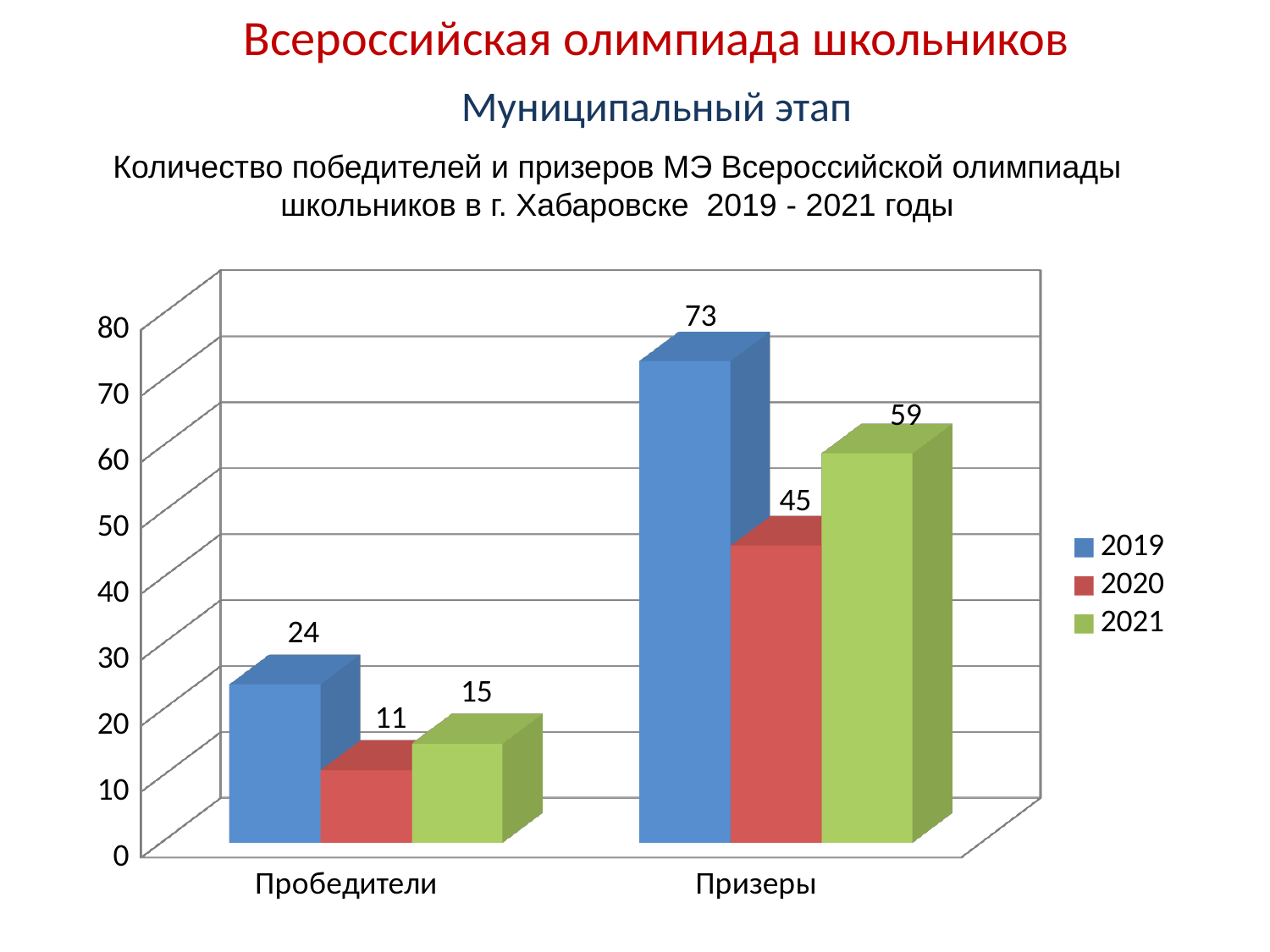
Which year has the lowest value in the Победители category? 2020 What is the difference between the 2019 and 2020 values in the Победители category? 13 What is the difference between the 2019 and 2021 values in the Призеры category? 14 Which year has the highest value in the Призеры category? 2019 Which colour represents the 2020 series in the legend? Red What is the value for 2019 in the Победители category? 24 What is the value for 2021 in the Победители category? 15 How many categories are shown on the x axis? 2 What kind of chart is shown on the slide? Bar chart What is the value for 2020 in the Призеры category? 45 How many series does the legend list? 3 Which is larger: the 2021 value for Призеры or the 2020 value for Призеры? 2021 value for Призеры